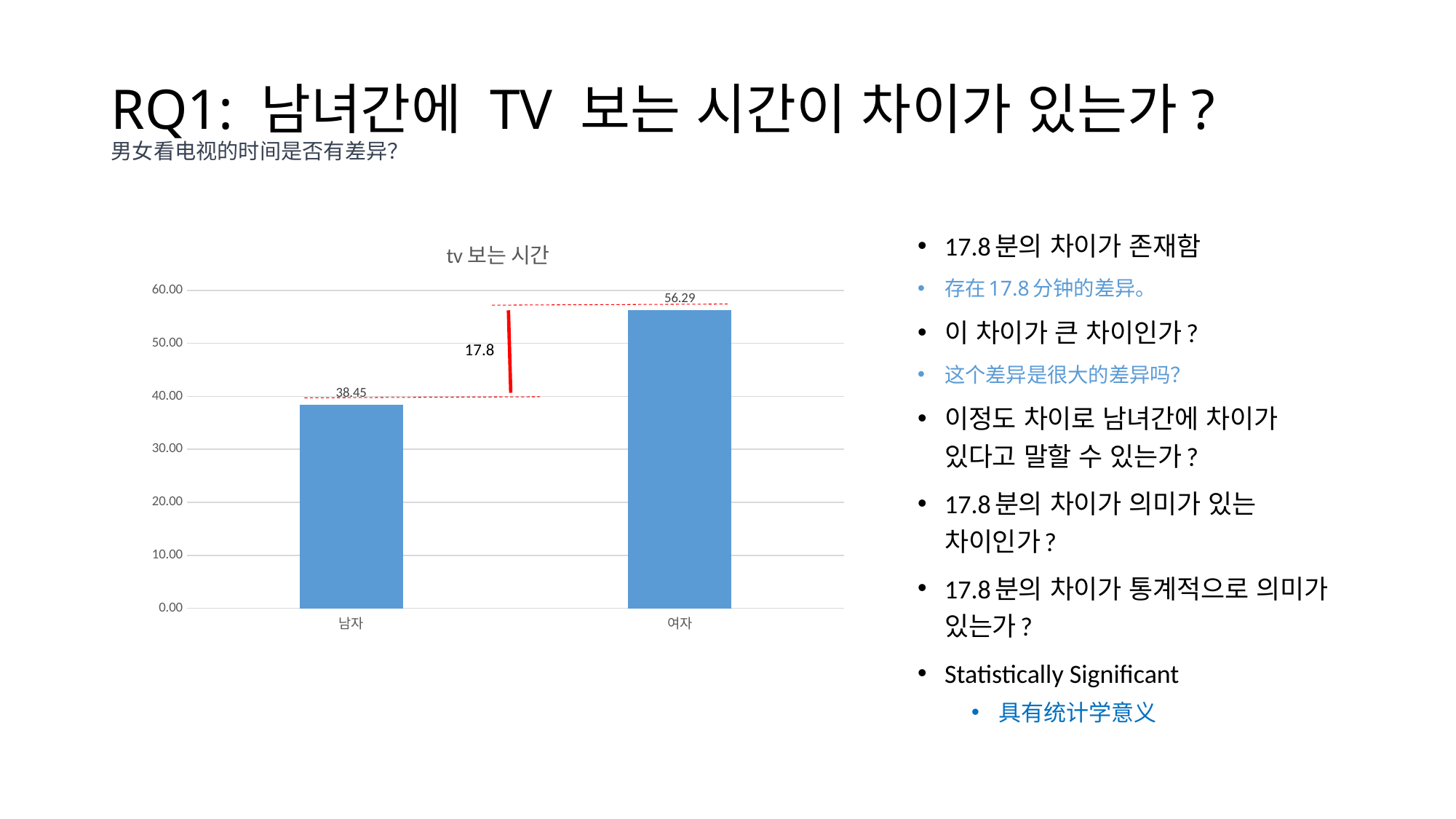
How many categories are shown in the chart? 2 Is the value for 여자 greater or less than 50.00? greater Which category has the lowest value in the chart? 남자 What is the highest tick value shown on the vertical axis of the chart? 60.00 Which category has the highest value in the chart? 여자 What is the title of the chart? tv 보는 시간 Which is larger, the value for 남자 or the value for 여자? 여자 What kind of chart is shown on the slide? bar chart What is the value for 남자 in the chart? 38.45 What is the difference between the values for 여자 and 남자? 17.84 What is the value for 여자 in the chart? 56.29 Is the value for 남자 greater or less than 40.00? less